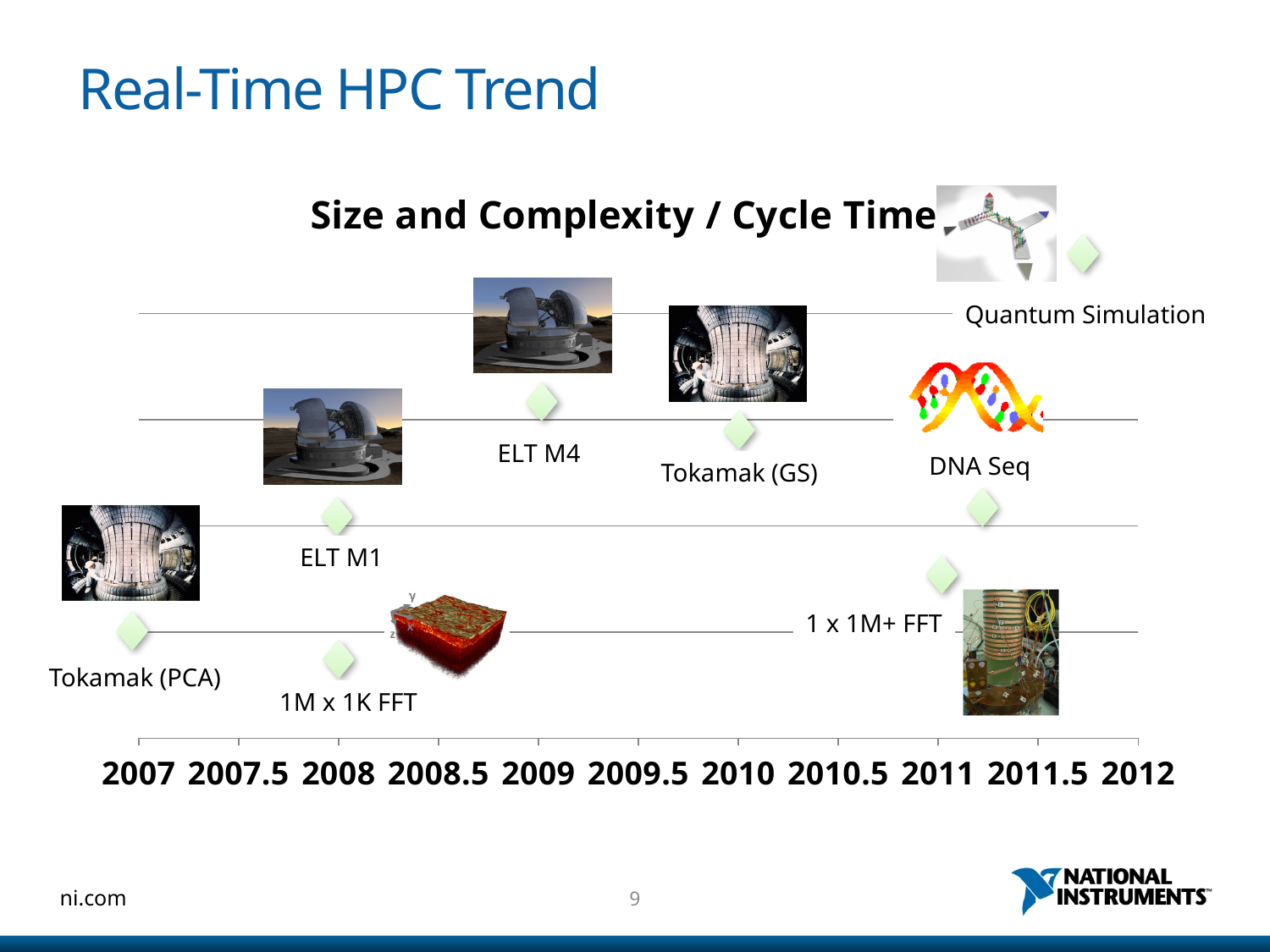
What kind of chart is shown on the slide? Scatter chart How many data points are plotted on the chart? 8 Which labelled point is plotted highest on the chart? Quantum Simulation At which year on the x axis is the ELT M4 point plotted? 2009 Which is plotted higher on the chart, ELT M4 or ELT M1? ELT M4 Which labelled point is plotted lowest on the chart? 1M x 1K FFT At which year on the x axis is the Tokamak (GS) point plotted? 2010 At which year on the x axis is the 1 x 1M+ FFT point plotted? 2011 What is the title of the chart? Size and Complexity / Cycle Time Is the x-axis position of the Quantum Simulation point greater or less than 2011.5? greater Which labelled point is plotted at the earliest year on the x axis? Tokamak (PCA) Do the plotted points rise or fall as the year increases along the x axis? Rise